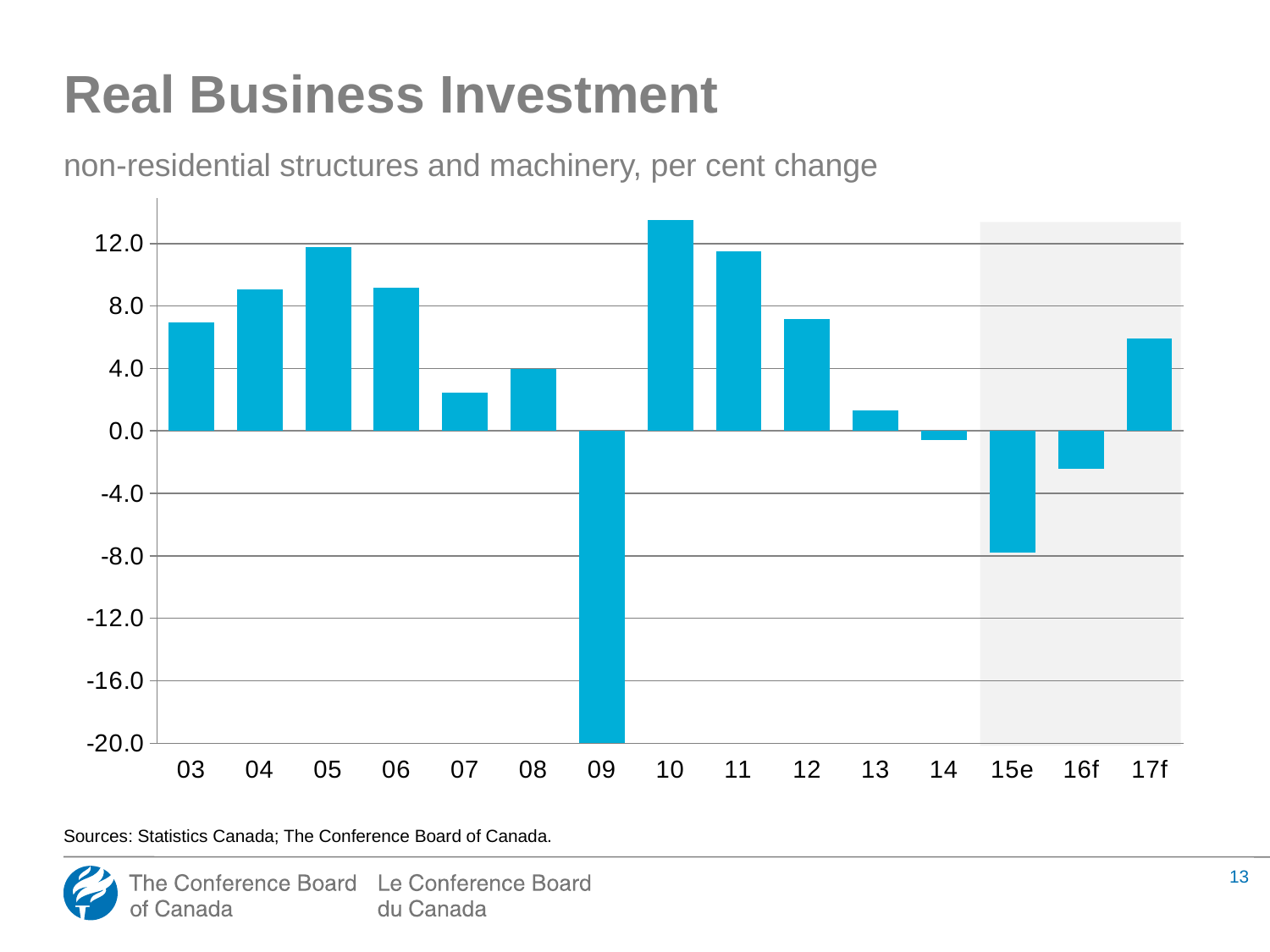
Which is larger, the value for 16f or the value for 15e? 16f Is the value for 15e greater or less than -4.0? less Which year has the lowest value? 09 How many years (categories) are plotted on the x axis? 15 Is the value for 07 greater or less than 4.0? less Do the values rise or fall from 10 to 14? fall Which year has the highest value? 10 Is the value for 17f greater or less than 4.0? greater What is the title of the chart? Real Business Investment What kind of chart is shown on the slide? bar chart Which is larger, the value for 04 or the value for 13? 04